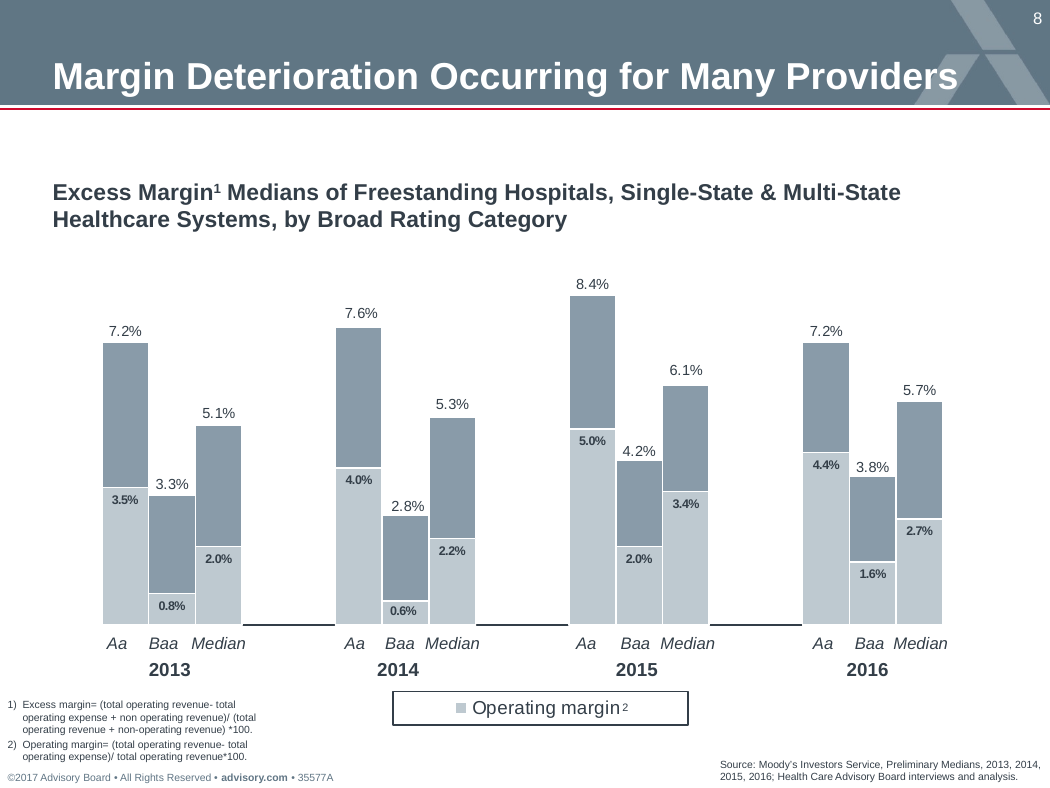
What is the excess margin median for Aa in 2015? 8.4% How many series does the legend list? 1 Which is larger, the operating margin for Median in 2015 or for Median in 2016? Median in 2015 Which bar has the lowest excess margin median across all years? Baa in 2014 What is the operating margin for Aa in 2016? 4.4% How many bars are plotted in the chart? 12 What is the operating margin for Baa in 2014? 0.6% What kind of chart is shown on the slide? Stacked bar chart What is the difference between the excess margin medians for Aa and Baa in 2013? 3.9% Does the excess margin median for Baa rise or fall from 2015 to 2016? Fall Which bar has the highest excess margin median across all years? Aa in 2015 What is the excess margin median for Median in 2016? 5.7%